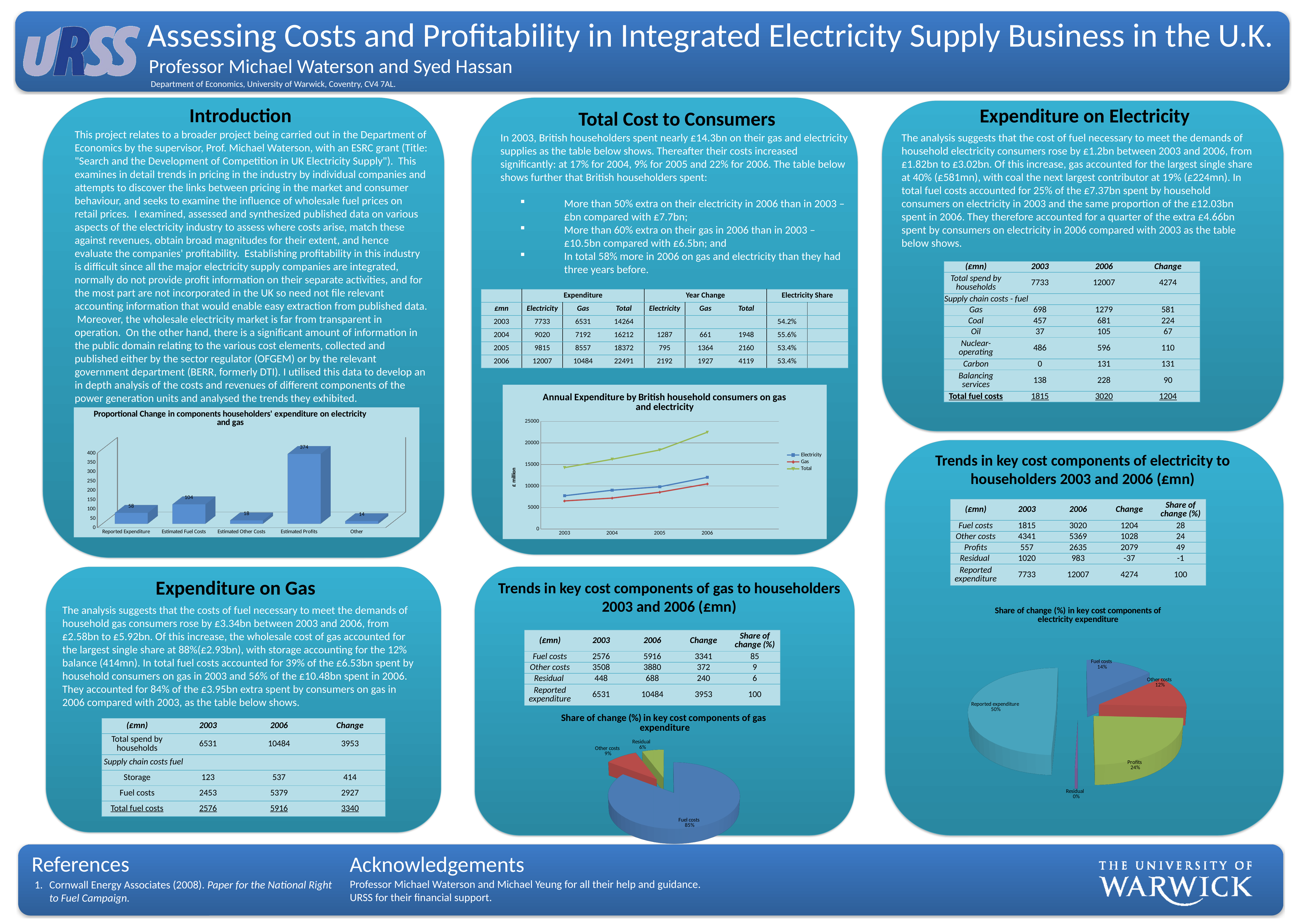
In the bar chart 'Proportional Change in components householders' expenditure on electricity and gas', how many categories are shown? 5 In the bar chart 'Proportional Change in components householders' expenditure on electricity and gas', what is the difference between Estimated Profits and Reported Expenditure? 316 In the bar chart 'Proportional Change in components householders' expenditure on electricity and gas', what is the value for Estimated Profits? 374 In the pie chart 'Share of change (%) in key cost components of gas expenditure', what share does Fuel costs have? 85% In the pie chart 'Share of change (%) in key cost components of gas expenditure', which slice is the smallest? Residual In the pie chart 'Share of change (%) in key cost components of electricity expenditure', which is larger, Fuel costs or Other costs? Fuel costs In the line chart 'Annual Expenditure by British household consumers on gas and electricity', does the Total series rise or fall from 2003 to 2006? rise In the pie chart 'Share of change (%) in key cost components of electricity expenditure', what share does Profits have? 24% In the bar chart 'Proportional Change in components householders' expenditure on electricity and gas', which category has the lowest value? Other In the line chart 'Annual Expenditure by British household consumers on gas and electricity', how many series does the legend list? 3 In the line chart 'Annual Expenditure by British household consumers on gas and electricity', is the Total value for 2006 greater or less than 20000? greater In the bar chart 'Proportional Change in components householders' expenditure on electricity and gas', what is the value for Estimated Fuel Costs? 104